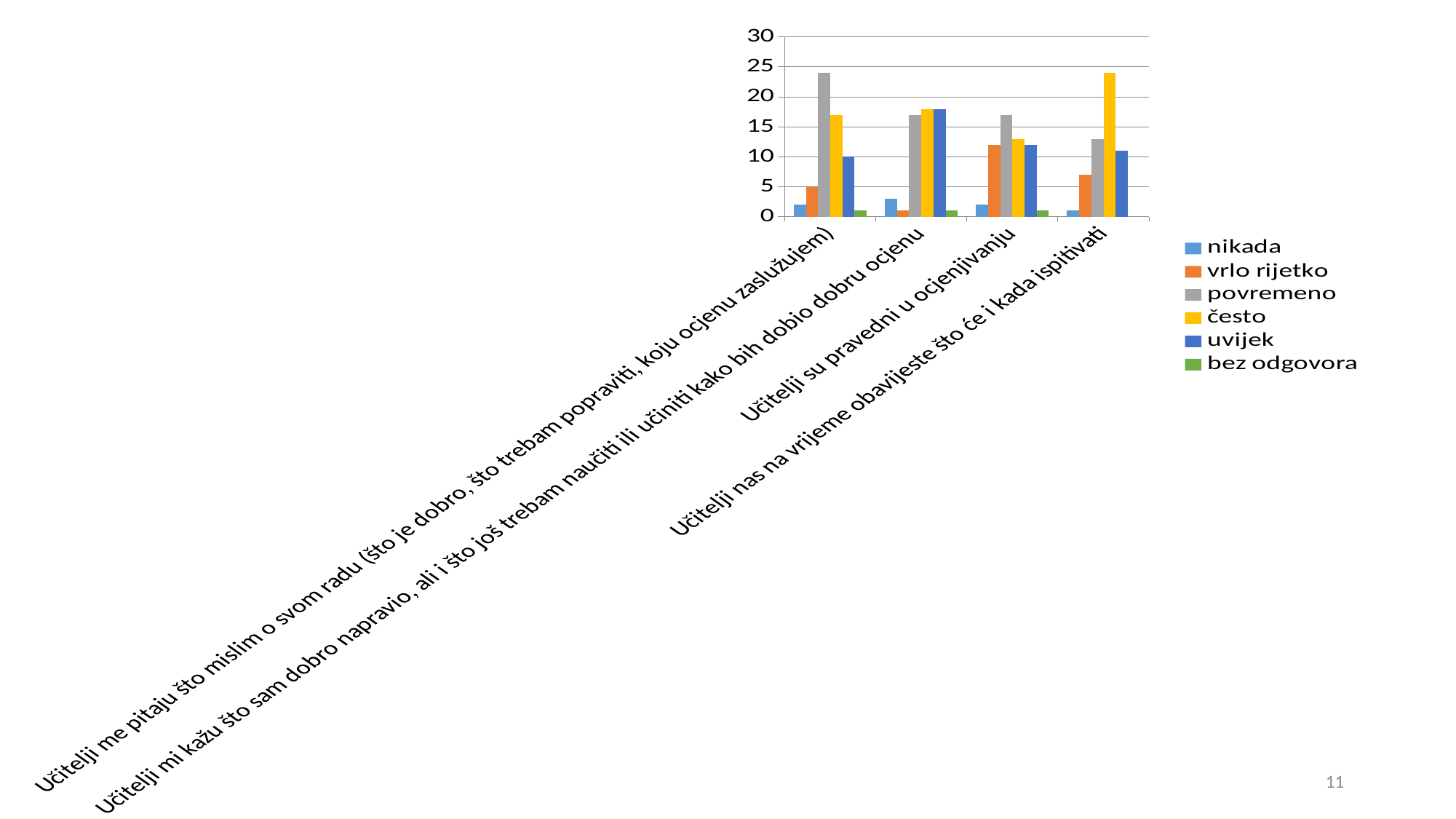
Is the value of "povremeno" for "Učitelji me pitaju što mislim o svom radu (što je dobro, što trebam popraviti, koju ocjenu zaslužujem)" greater or less than 20? greater How many categories are shown on the x axis? 4 Is the value of "često" for "Učitelji nas na vrijeme obavijeste što će i kada ispitivati" greater or less than 20? greater How many series does the legend list? 6 Is the value of "uvijek" for "Učitelji mi kažu što sam dobro napravio, ali i što još trebam naučiti ili učiniti kako bih dobio dobru ocjenu" greater or less than 15? greater Which series has the highest value for the category "Učitelji su pravedni u ocjenjivanju"? povremeno Which series has the highest value for the category "Učitelji nas na vrijeme obavijeste što će i kada ispitivati"? često Which is larger: the "povremeno" value for "Učitelji me pitaju što mislim o svom radu (što je dobro, što trebam popraviti, koju ocjenu zaslužujem)" or the "povremeno" value for "Učitelji nas na vrijeme obavijeste što će i kada ispitivati"? Učitelji me pitaju što mislim o svom radu (što je dobro, što trebam popraviti, koju ocjenu zaslužujem) What kind of chart is shown on the slide? bar chart Which series has the highest value for the category "Učitelji me pitaju što mislim o svom radu (što je dobro, što trebam popraviti, koju ocjenu zaslužujem)"? povremeno What colour represents the series "često" in the legend? yellow